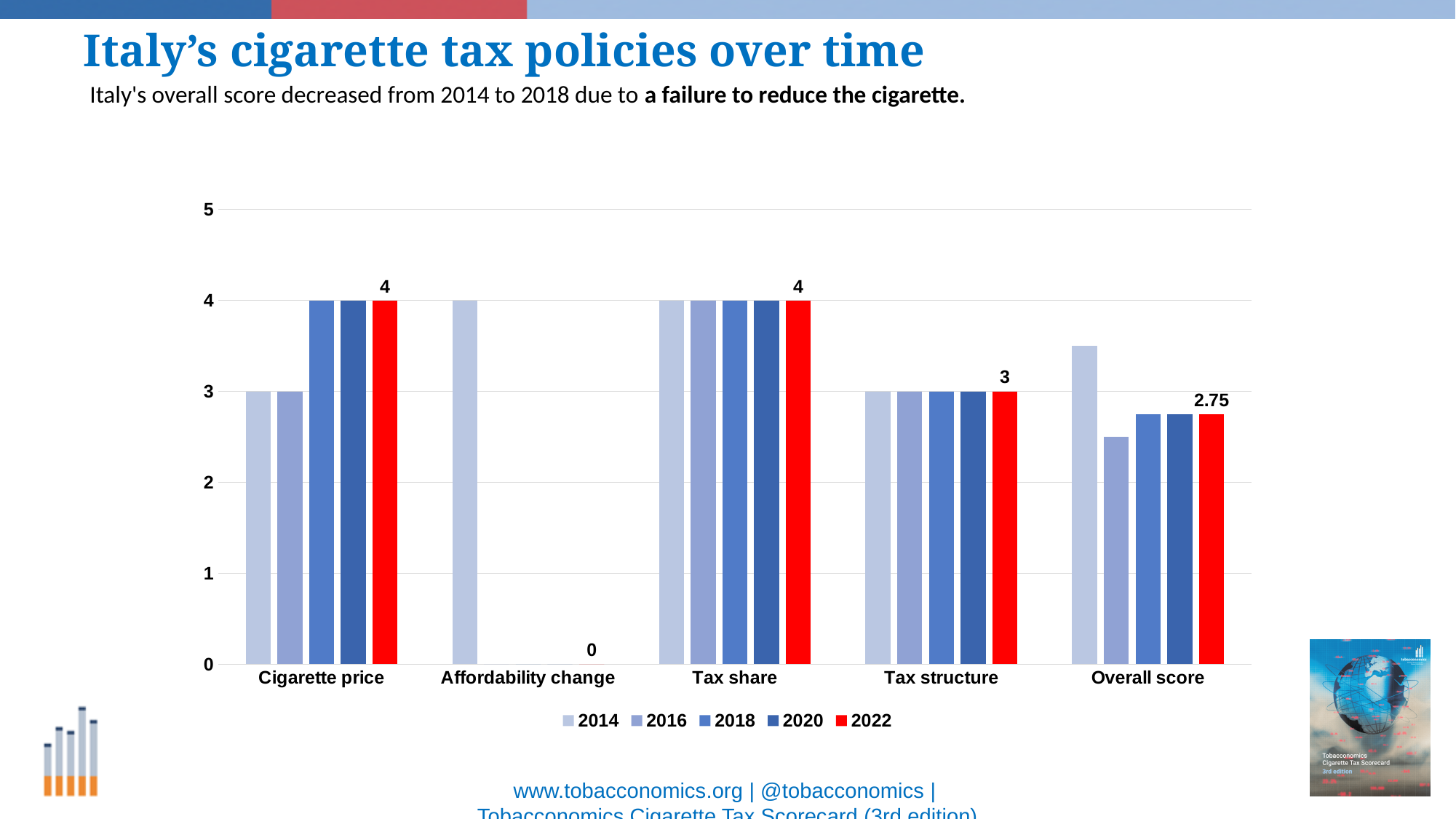
What kind of chart is shown on the slide? Bar chart What is the value for Overall score in 2022? 2.75 How many categories are shown on the x axis? 5 Is the value for Overall score in 2014 greater or less than 3? greater What is the value for Affordability change in 2022? 0 In 2022, which is larger: Tax share or Tax structure? Tax share What is the value for Cigarette price in 2022? 4 How many series does the legend list? 5 What is the difference between the 2022 values for Tax share and Tax structure? 1 What is the value for Tax structure in 2022? 3 Which category has the lowest value in 2022? Affordability change Is the value for Overall score in 2016 greater or less than 3? less